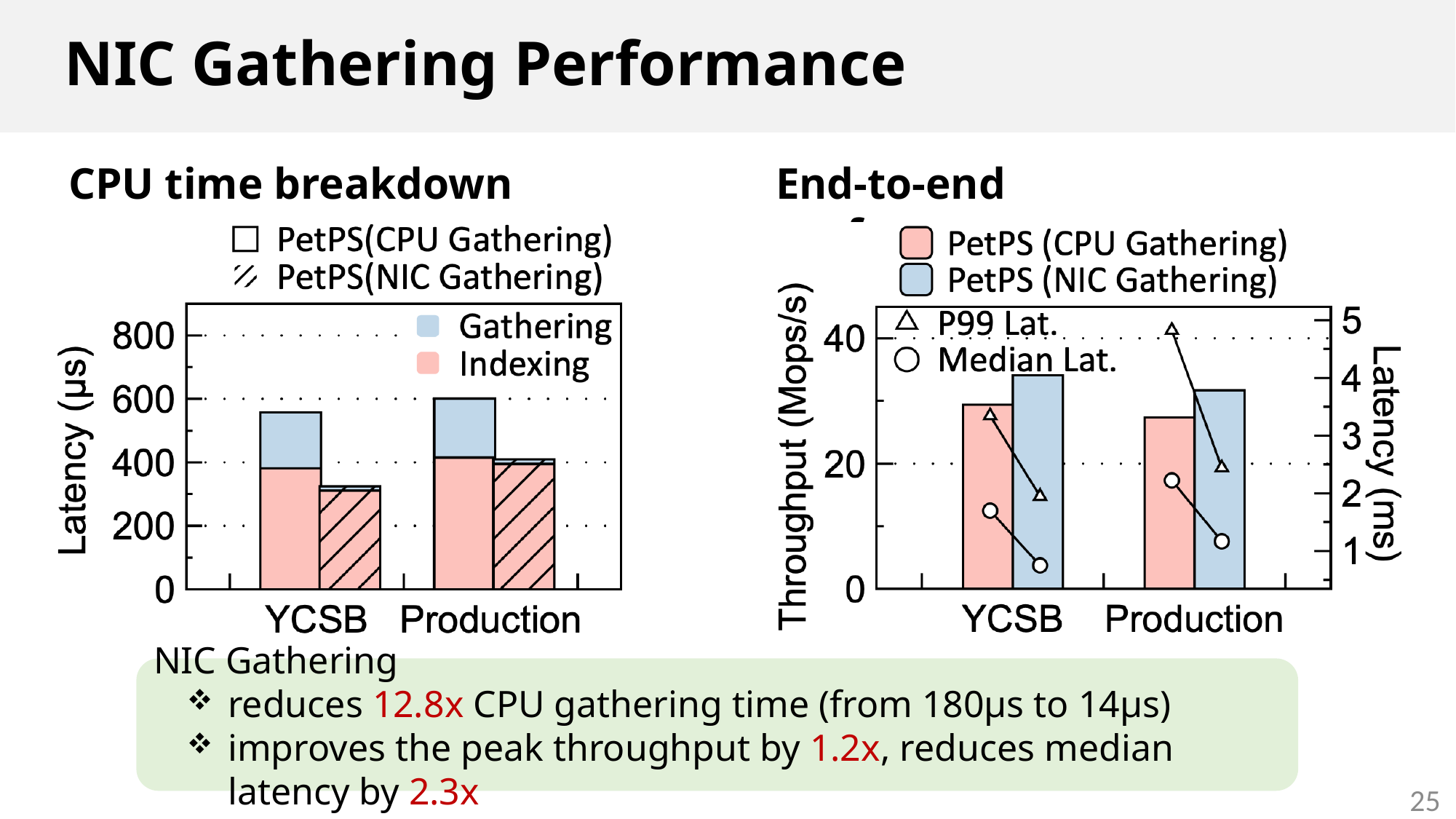
In the CPU time breakdown chart, which two components make up each stacked bar according to the legend? Gathering and Indexing In the CPU time breakdown chart, how many workload categories are shown on the x axis? 2 In the CPU time breakdown chart, is the total latency of PetPS(CPU Gathering) for YCSB greater or less than 400? greater In the CPU time breakdown chart, what kind of chart is it? stacked bar chart In the CPU time breakdown chart, is the total latency of PetPS(CPU Gathering) for Production greater or less than 400? greater In the End-to-end chart, is the P99 latency of PetPS (CPU Gathering) for Production greater or less than 4 ms? greater In the End-to-end chart, what does the right-hand y axis measure? Latency (ms) In the End-to-end chart, for YCSB, which has the higher throughput: PetPS (CPU Gathering) or PetPS (NIC Gathering)? PetPS (NIC Gathering) In the CPU time breakdown chart, for YCSB, which has the higher total latency: PetPS(CPU Gathering) or PetPS(NIC Gathering)? PetPS(CPU Gathering)